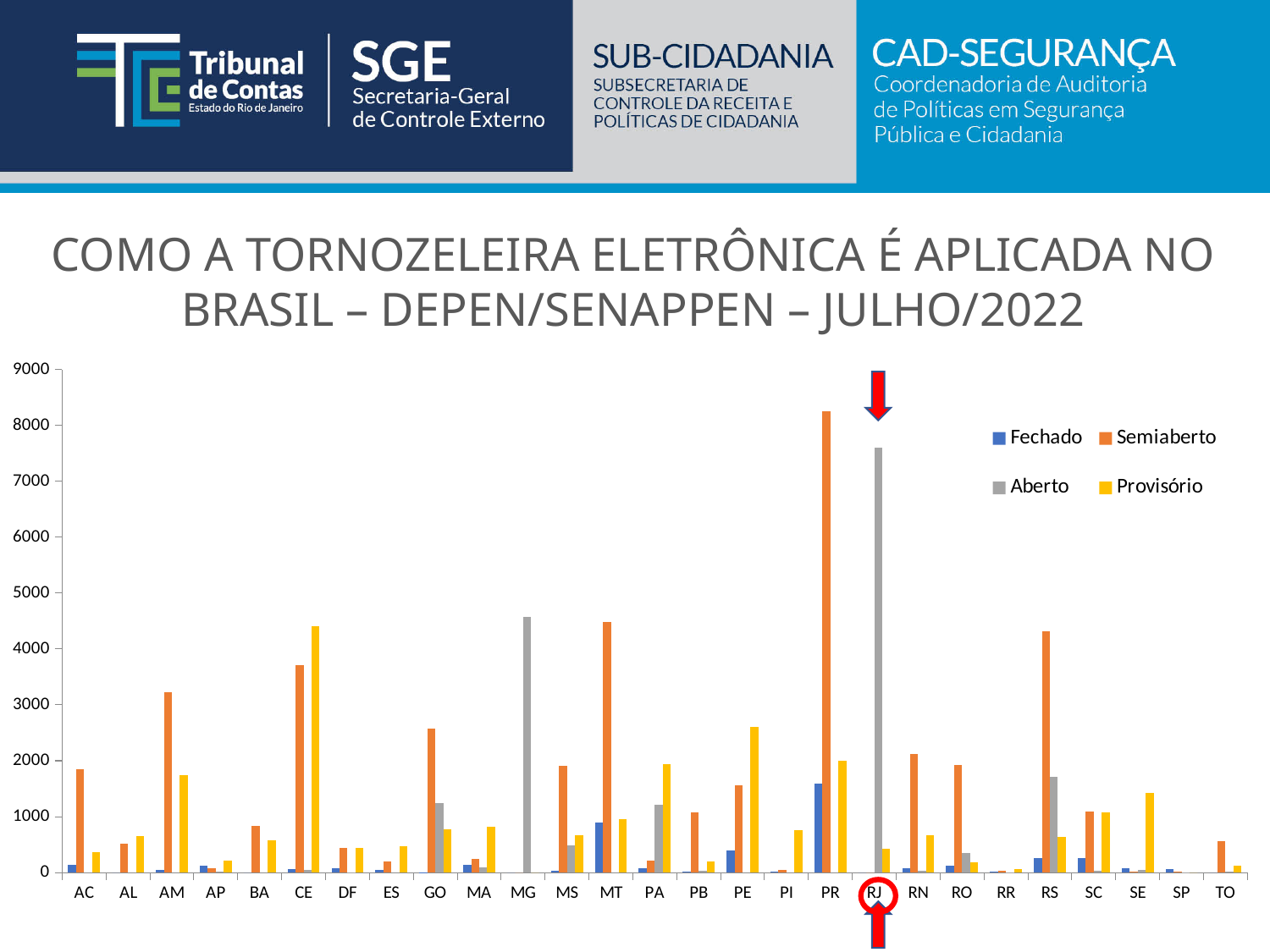
Is the Semiaberto value for PR greater or less than 8000? greater Which state is highlighted with red arrows on the chart? RJ Which state has the highest Provisório value? CE Which is larger: the Semiaberto value for MT or the Semiaberto value for AM? MT Which state has the highest Aberto value? RJ How many series does the legend list? 4 Is the Semiaberto value for AM greater or less than 3000? greater Is the Aberto value for RJ greater or less than 8000? less How many states (categories) are shown on the x axis? 27 What kind of chart is shown on the slide? bar chart Which state has the highest Semiaberto value? PR